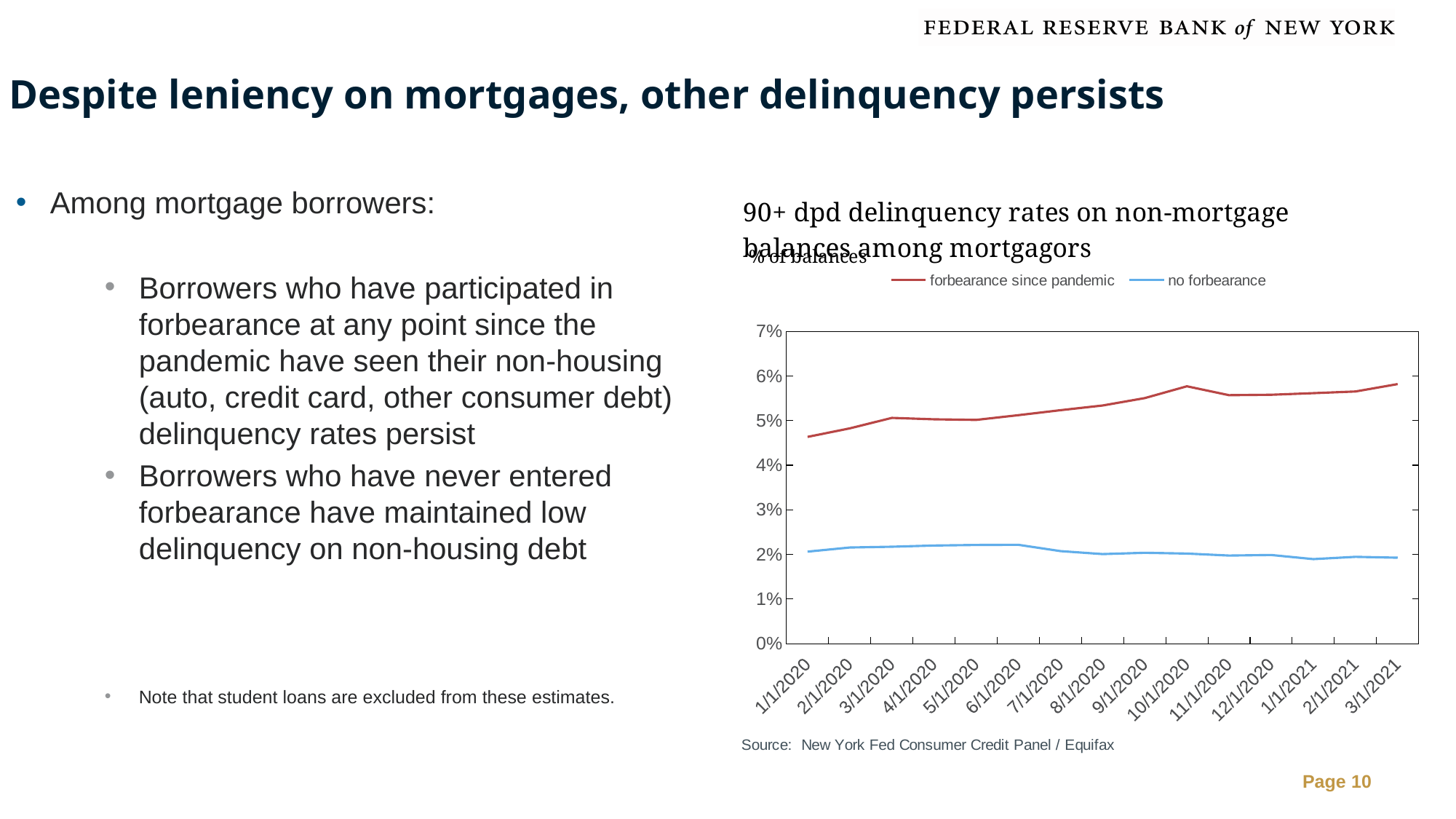
Does the forbearance since pandemic series generally rise or fall from 1/1/2020 to 3/1/2021? rise Which series has the higher delinquency rate at 10/1/2020, forbearance since pandemic or no forbearance? forbearance since pandemic What colour is the line for the no forbearance series? blue What is the title of the chart? 90+ dpd delinquency rates on non-mortgage balances among mortgagors Is the value for forbearance since pandemic at 10/1/2020 greater or less than 5%? greater Is the value for forbearance since pandemic at 1/1/2020 greater or less than 4%? greater How many series does the legend list? 2 Is the value for no forbearance at 6/1/2020 greater or less than 3%? less How many dates are labelled on the x axis of the chart? 15 What kind of chart is shown on the slide? line chart At which date is the forbearance since pandemic series at its lowest? 1/1/2020